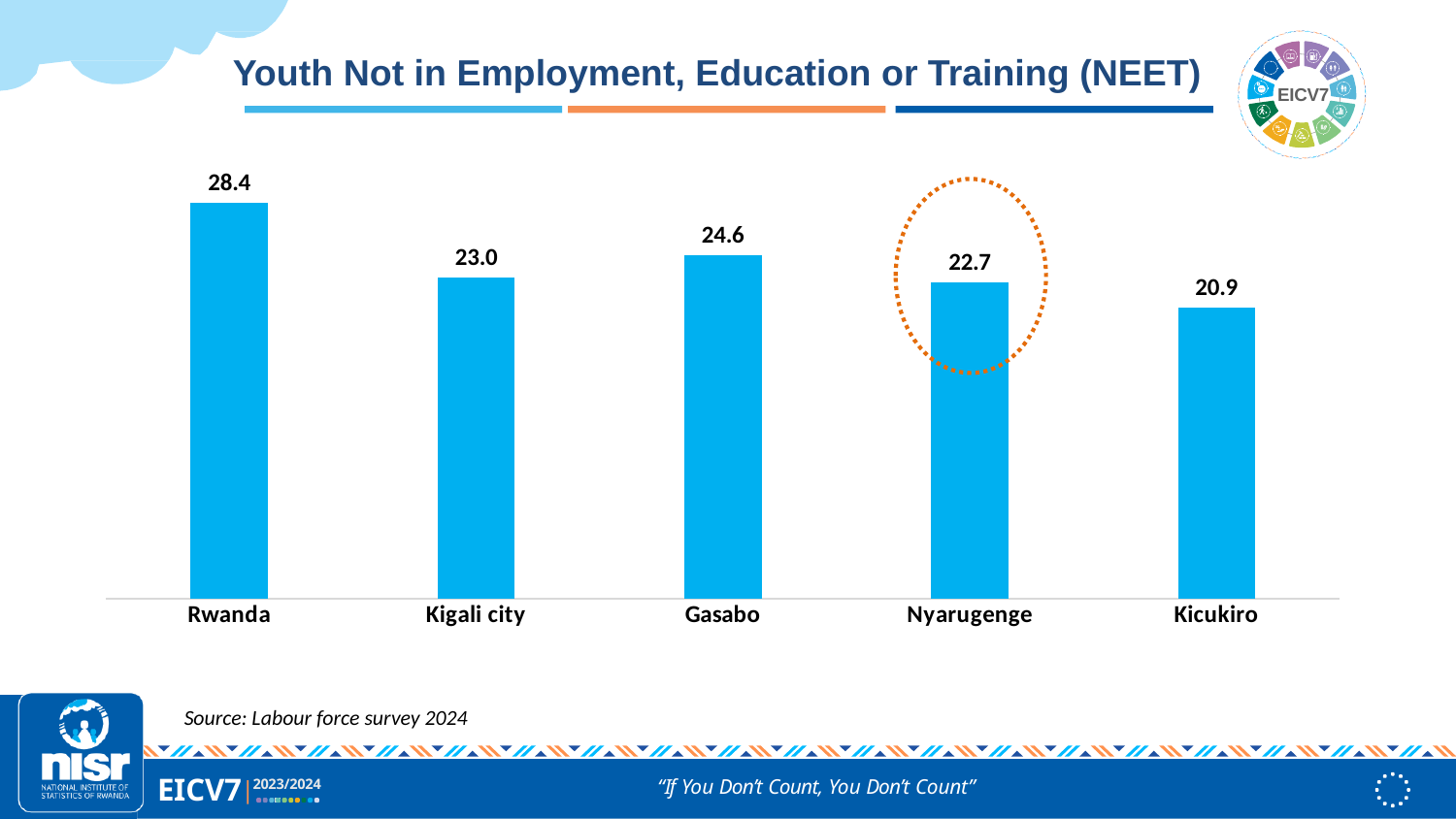
What is the difference between the NEET values for Gasabo and Nyarugenge? 1.9 Which category has the highest NEET value? Rwanda What kind of chart is shown on the slide? Bar chart What is the difference between the NEET values for Rwanda and Kicukiro? 7.5 Which has a higher NEET value, Gasabo or Kigali city? Gasabo What is the NEET value for Kigali city? 23.0 Which bar is highlighted with a dotted orange circle? Nyarugenge What is the NEET value for Rwanda? 28.4 How many categories are shown in the chart? 5 Which category has the lowest NEET value? Kicukiro What is the NEET value for Kicukiro? 20.9 What is the NEET value for Nyarugenge? 22.7